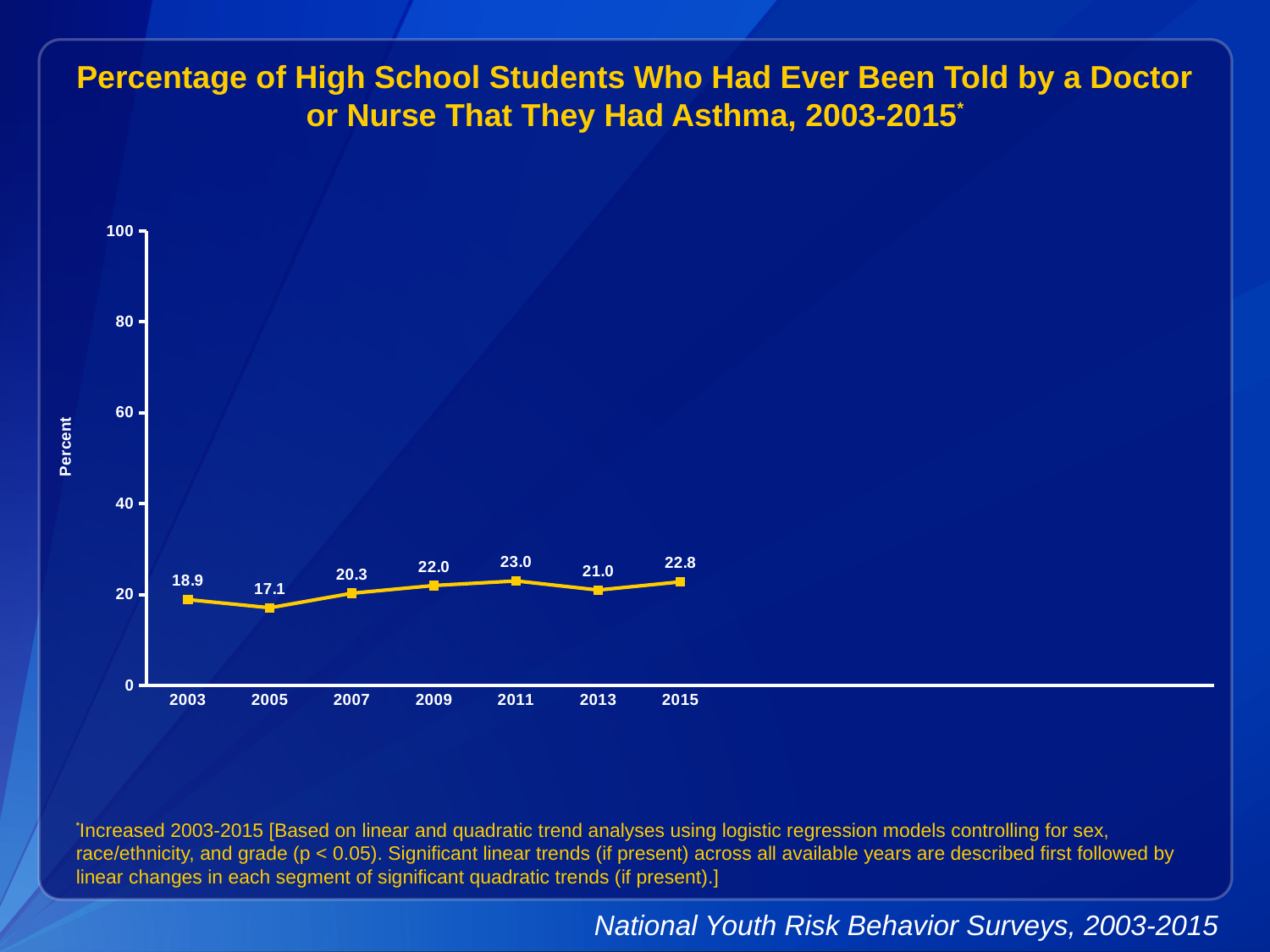
What kind of chart is shown on the slide? line chart What percentage of high school students had ever been told they had asthma in 2003? 18.9 What is the difference between the 2011 value and the 2005 value? 5.9 Which year has the highest value on the chart? 2011 Is the value for 2007 greater or less than 40? less What is the value plotted for 2015? 22.8 What is the label on the vertical axis? Percent Which year has the larger value, 2009 or 2013? 2009 What is the difference between the 2015 value and the 2003 value? 3.9 Which year has the lowest value on the chart? 2005 What is the value plotted for 2011? 23.0 How many years are plotted on the chart? 7